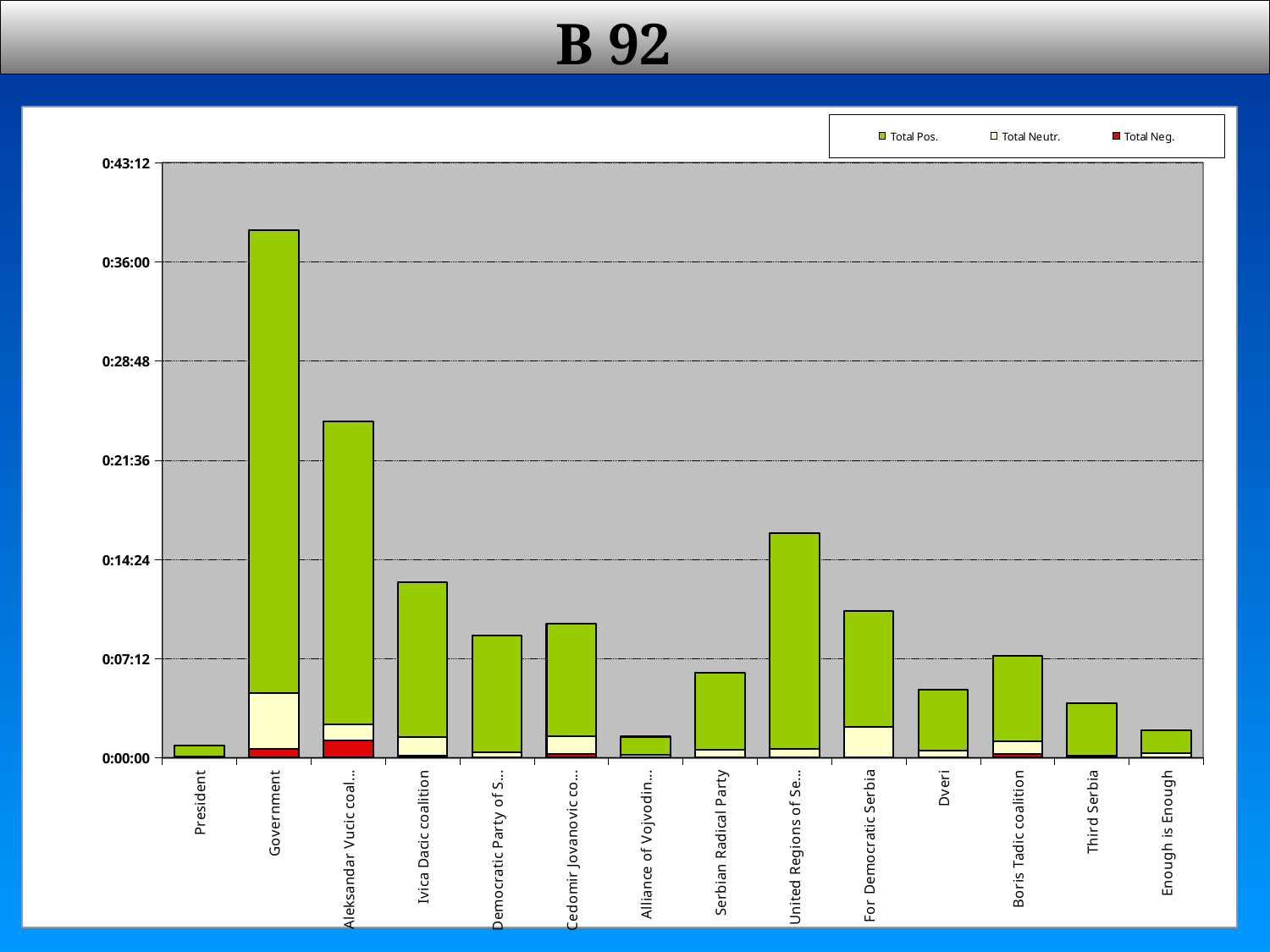
Which category has the tallest stacked bar? Government Is the total value for Serbian Radical Party greater or less than 0:07:12? less How many categories are shown on the x axis? 14 What colour represents the Total Neg. series in the legend? Red What kind of chart is shown on the slide? Stacked bar chart Is the total value for United Regions of Se... greater or less than 0:14:24? greater Which category has the largest Total Neutr. segment? Government Which has the larger total bar, Ivica Dacic coalition or Cedomir Jovanovic co...? Ivica Dacic coalition Which has the larger total bar, Third Serbia or Enough is Enough? Third Serbia How many series does the legend list? 3 Is the total value for Government greater or less than 0:36:00? greater